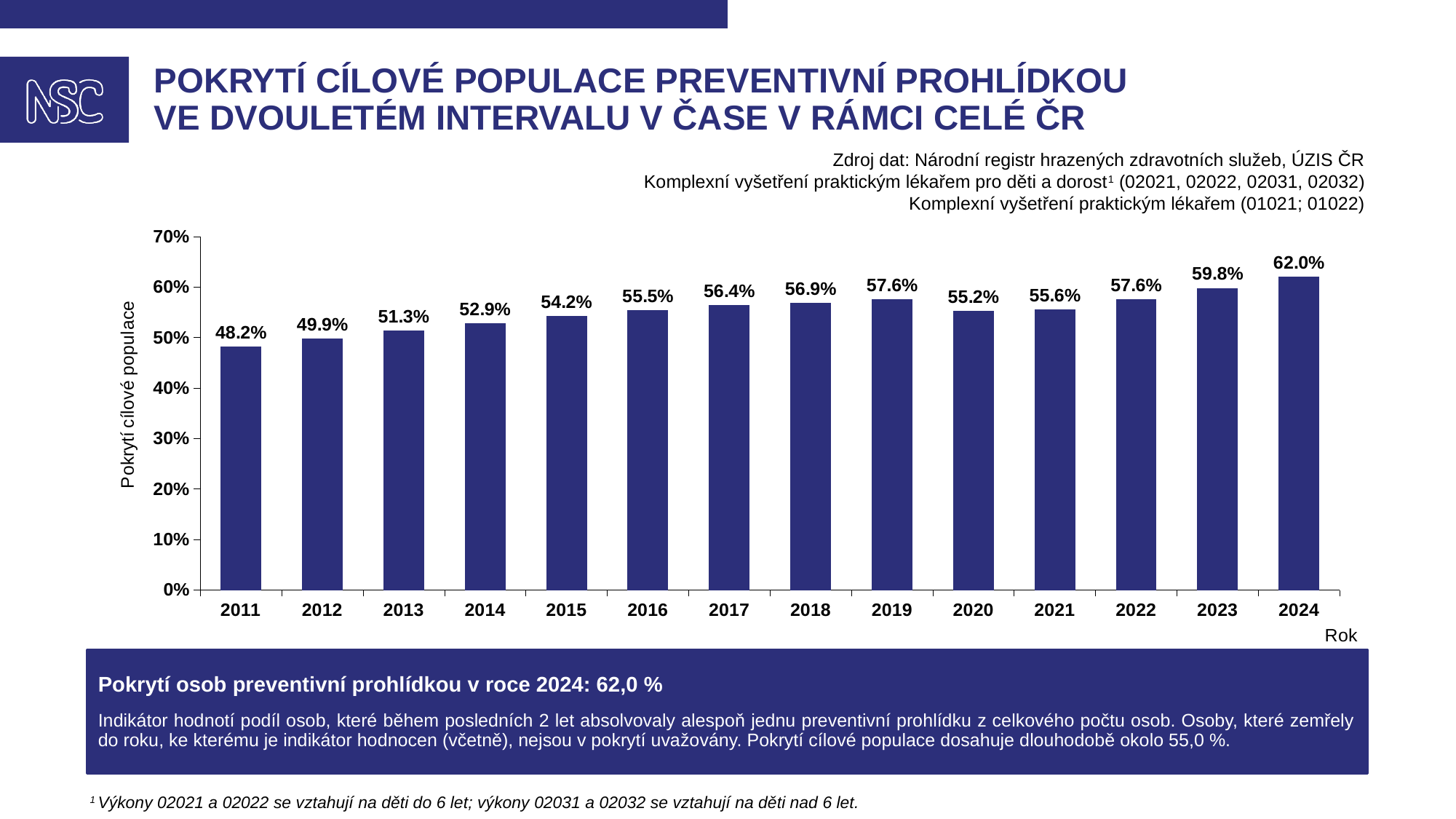
What is the coverage value for 2023? 59.8% What is the coverage value for 2011? 48.2% Which year has a higher coverage, 2017 or 2021? 2017 What is the difference between the coverage in 2024 and in 2011? 13.8% Which year has the lowest coverage? 2011 How many years are shown on the x axis? 14 Is the value for 2014 greater or less than 50%? greater Which year has the highest coverage? 2024 What is the label of the y axis? Pokrytí cílové populace What kind of chart is shown on the slide? bar chart What is the coverage value for 2020? 55.2% What is the difference between the coverage in 2019 and in 2020? 2.4%